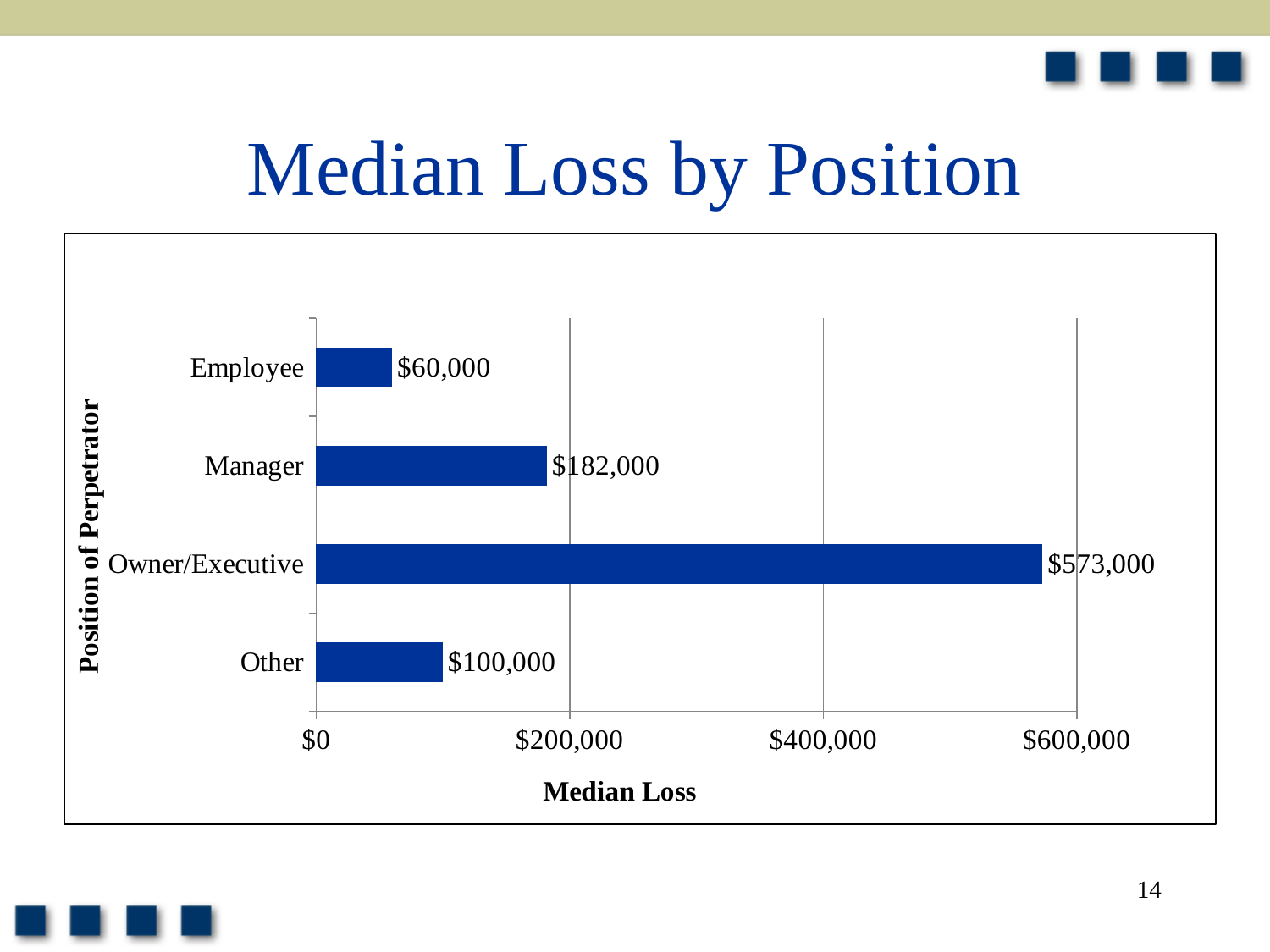
What is the median loss for Manager? $182,000 What type of chart is shown on the slide? bar chart What is the difference between the median loss for Other and Employee? $40,000 What is the median loss for Owner/Executive? $573,000 Which has a larger median loss, Manager or Other? Manager Which position has the highest median loss? Owner/Executive Which position has the lowest median loss? Employee What is the median loss for Employee? $60,000 What is the median loss for Other? $100,000 What is the difference between the median loss for Owner/Executive and Manager? $391,000 Is the median loss for Owner/Executive greater or less than $400,000? greater How many positions are shown in the chart? 4